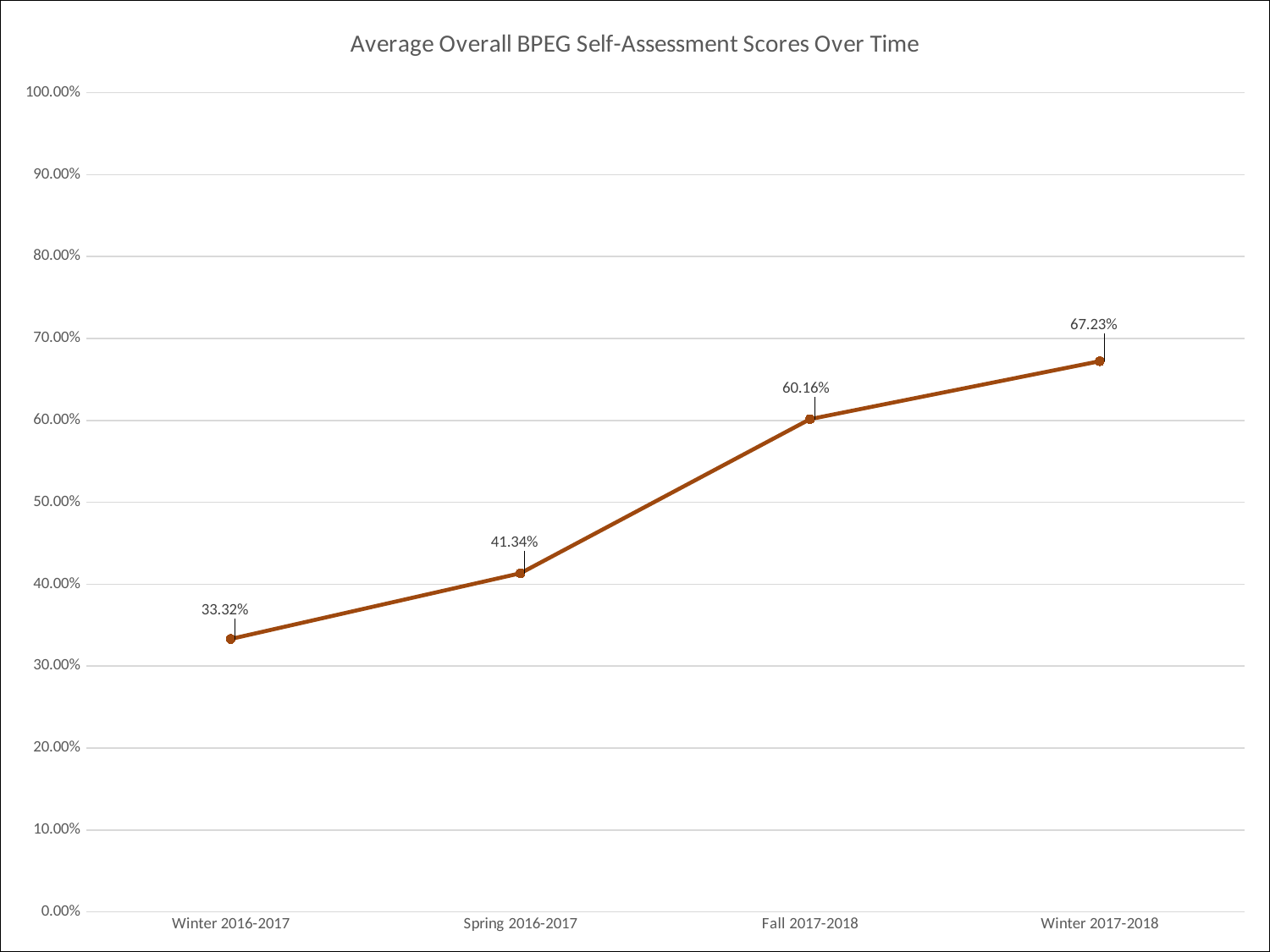
Which is larger, the score for Spring 2016-2017 or the score for Fall 2017-2018? Fall 2017-2018 Do the scores rise or fall from Winter 2016-2017 to Winter 2017-2018? rise What is the average overall BPEG self-assessment score for Winter 2017-2018? 67.23% What is the average overall BPEG self-assessment score for Winter 2016-2017? 33.32% Which period has the lowest average overall BPEG self-assessment score? Winter 2016-2017 What is the difference between the scores for Fall 2017-2018 and Spring 2016-2017? 18.82% What is the average overall BPEG self-assessment score for Fall 2017-2018? 60.16% What kind of chart is shown on the slide? line chart Which period has the highest average overall BPEG self-assessment score? Winter 2017-2018 Is the value for Winter 2017-2018 greater or less than 70.00%? less How many time periods are plotted on the chart? 4 What is the average overall BPEG self-assessment score for Spring 2016-2017? 41.34%